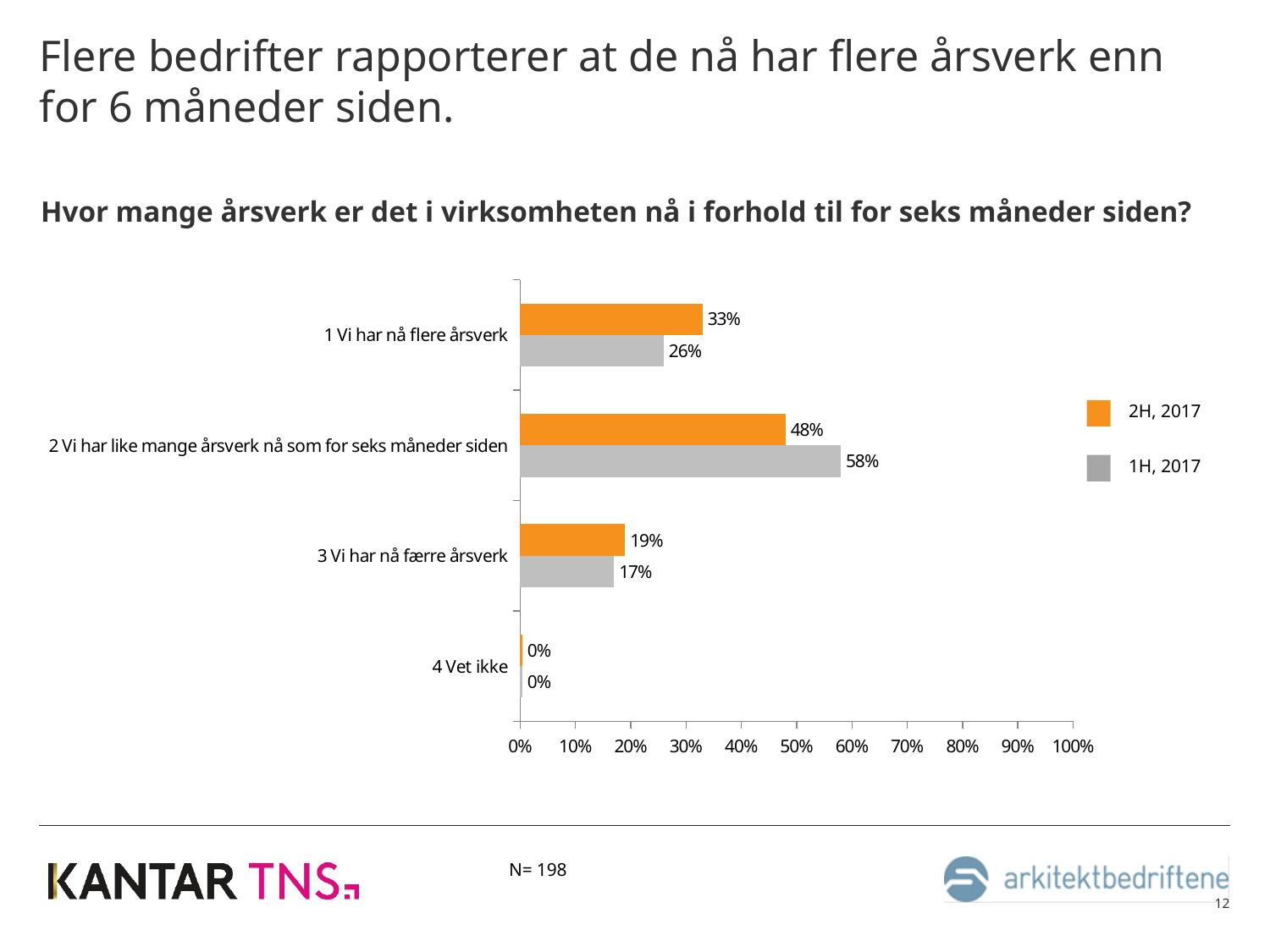
What is the value for "1 Vi har nå flere årsverk" in the 2H, 2017 series? 33% What is the difference between the 1H, 2017 and 2H, 2017 values for "2 Vi har like mange årsverk nå som for seks måneder siden"? 10% What kind of chart is shown on the slide? Bar chart Which category has the lowest value in the 2H, 2017 series? 4 Vet ikke For "3 Vi har nå færre årsverk", which series has the larger value, 2H, 2017 or 1H, 2017? 2H, 2017 What is the value for "3 Vi har nå færre årsverk" in the 2H, 2017 series? 19% How many categories are shown on the chart? 4 How many series does the legend list? 2 What is the value for "2 Vi har like mange årsverk nå som for seks måneder siden" in the 1H, 2017 series? 58% Which category has the highest value in the 1H, 2017 series? 2 Vi har like mange årsverk nå som for seks måneder siden Which colour represents the 2H, 2017 series in the chart? Orange What is the difference between the 2H, 2017 and 1H, 2017 values for "1 Vi har nå flere årsverk"? 7%